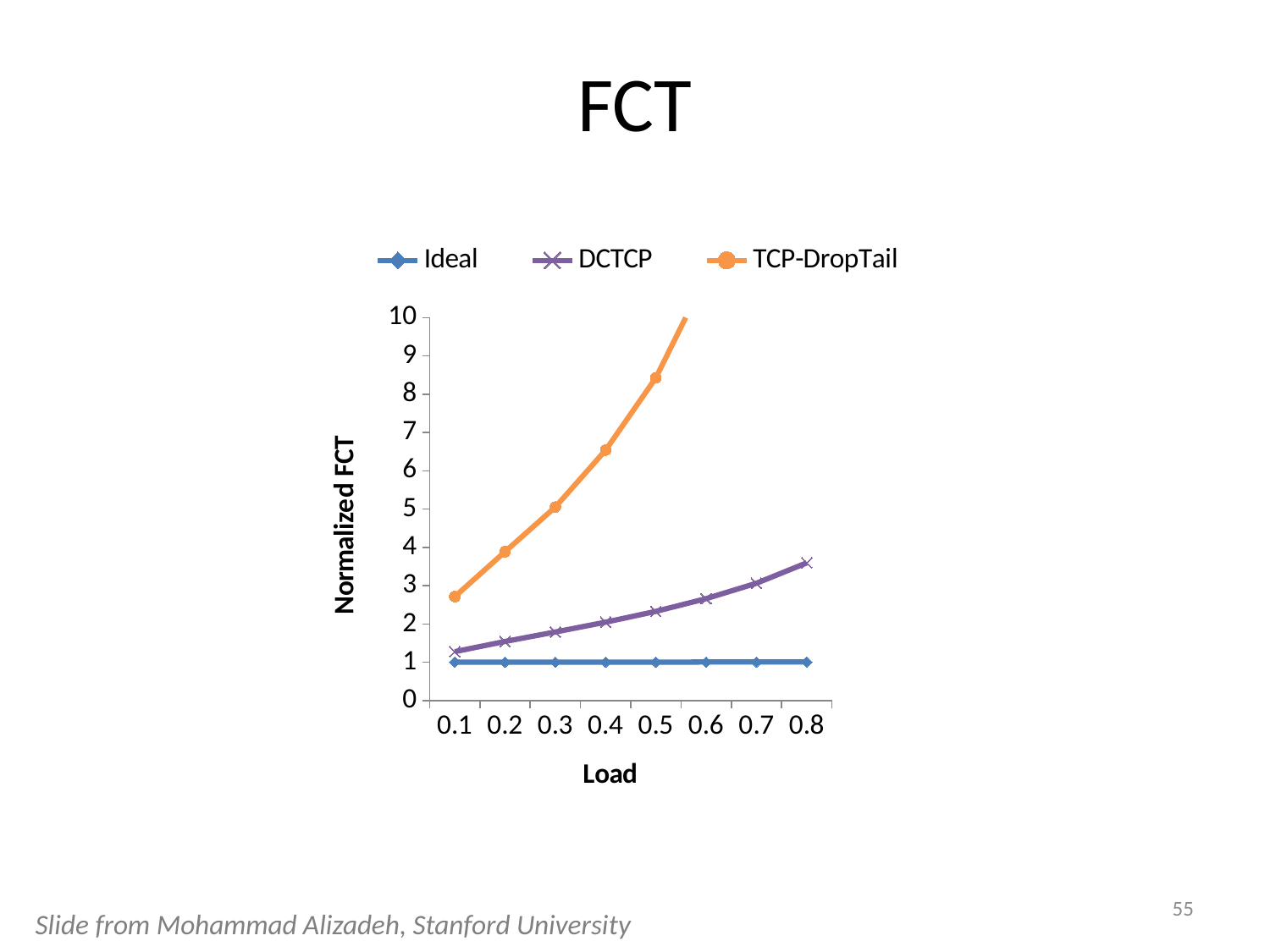
What is the Normalized FCT for Ideal at Load 0.1? 1 At Load 0.4, which series has the larger Normalized FCT, DCTCP or TCP-DropTail? TCP-DropTail Does the Ideal line rise, fall, or stay flat as Load increases? stays flat How many series does the legend list? 3 How many Load values are shown on the x axis? 8 Which series has the highest Normalized FCT at Load 0.3? TCP-DropTail Does the DCTCP line rise or fall as Load increases from 0.1 to 0.8? rises Is the DCTCP value at Load 0.8 greater or less than 3? greater Is the TCP-DropTail value at Load 0.5 greater or less than 8? greater Is the TCP-DropTail value at Load 0.1 greater or less than 2? greater What kind of chart is shown on the slide? line chart What is the title of the y axis? Normalized FCT